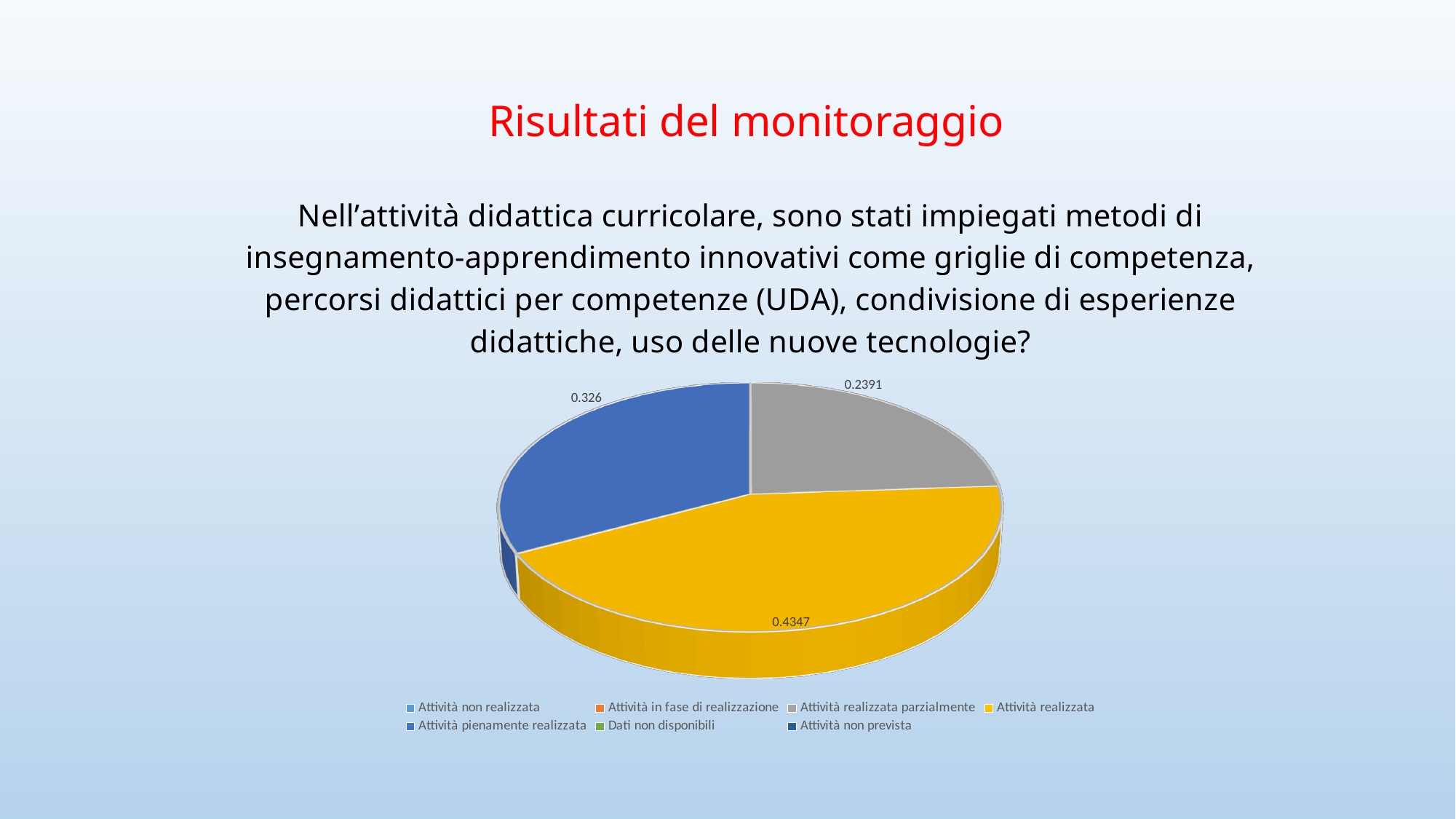
Which is larger, "Attività pienamente realizzata" or "Attività realizzata parzialmente"? Attività pienamente realizzata Which of the labelled slices is the smallest? Attività realizzata parzialmente What is the difference between the values for "Attività pienamente realizzata" and "Attività realizzata parzialmente"? 0.0869 What is the difference between the values for "Attività realizzata" and "Attività pienamente realizzata"? 0.1087 What is the value for "Attività pienamente realizzata"? 0.326 How many slices with data labels are visible in the pie? 3 Which category has the largest slice of the pie? Attività realizzata What kind of chart is shown on the slide? pie chart What is the value for "Attività realizzata parzialmente"? 0.2391 What colour is the slice for "Attività realizzata"? yellow What is the value for "Attività realizzata"? 0.4347 How many entries does the legend list? 7